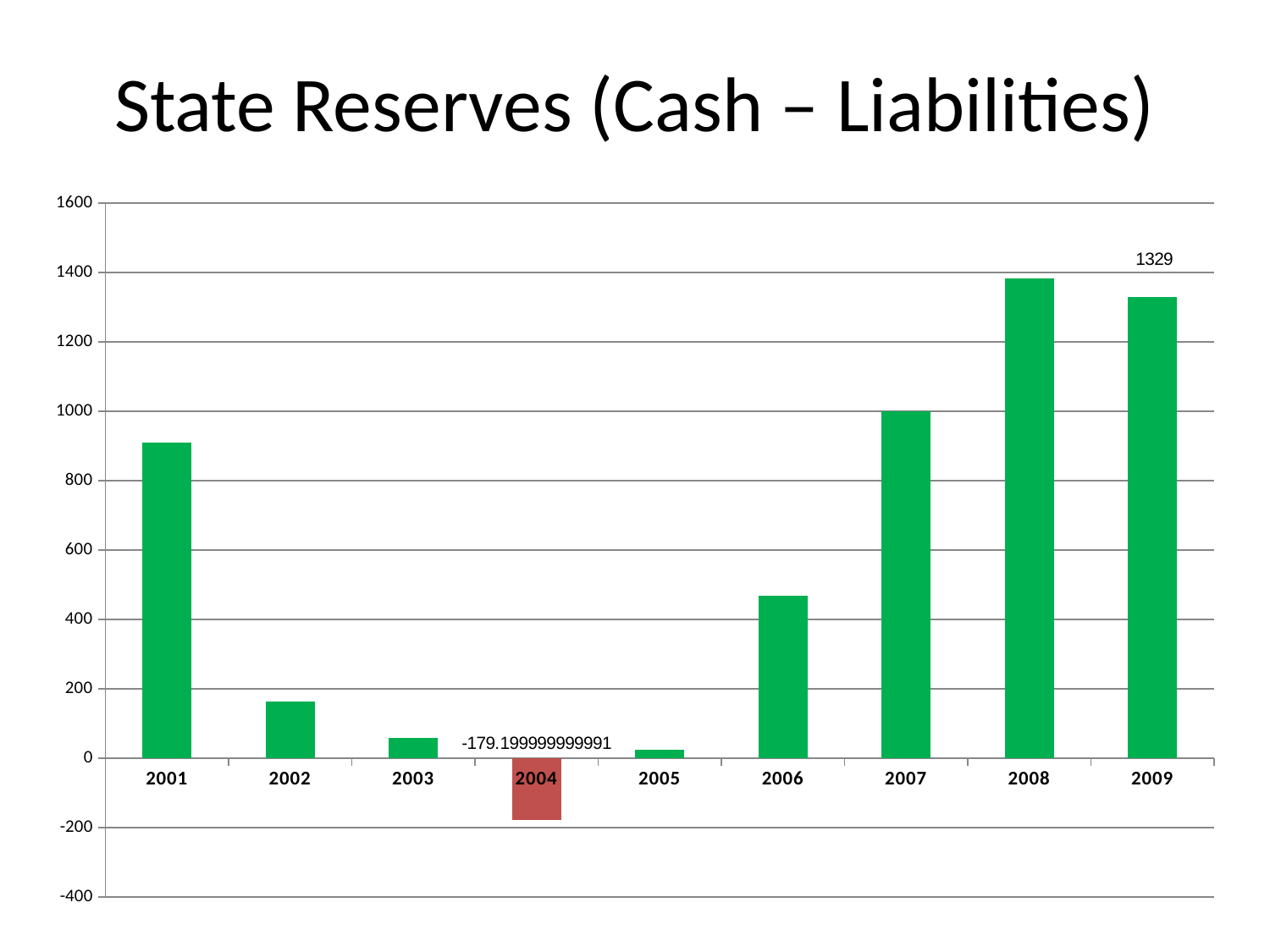
What is the title of the chart? State Reserves (Cash – Liabilities) Which year has the lowest value? 2004 What is the value for 2004? -179.199999999991 Which is larger, the value for 2001 or the value for 2006? 2001 Which year has the highest value? 2008 What is the value for 2009? 1329 What kind of chart is shown on the slide? bar chart Is the value for 2001 greater or less than 800? greater Is the value for 2002 greater or less than 200? less Is the value for 2006 greater or less than 400? greater How many years are shown on the x axis? 9